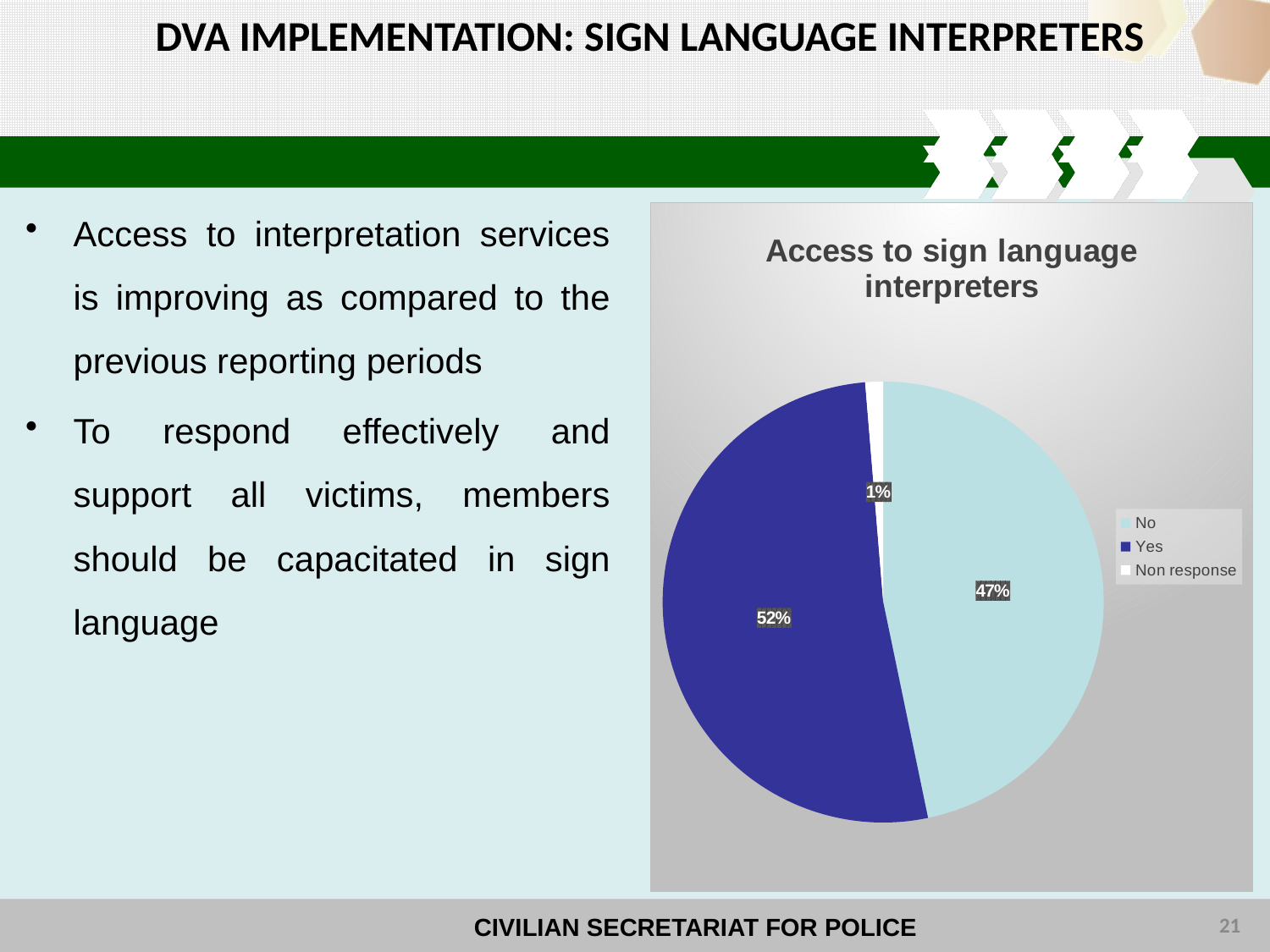
How many categories does the legend list? 3 What percentage of the pie is labelled "No"? 47% Which category has the smallest share of the pie? Non response What percentage of the pie is labelled "Yes"? 52% Which category has the largest share of the pie? Yes What is the combined share of the "Yes" and "No" slices? 99% What kind of chart is shown on the slide? pie chart What percentage of the pie is labelled "Non response"? 1% What is the title of the chart? Access to sign language interpreters What colour is the "Yes" slice in the pie chart? dark blue Which is larger, the "Yes" slice or the "No" slice? Yes What is the difference in percentage points between the "Yes" and "No" slices? 5